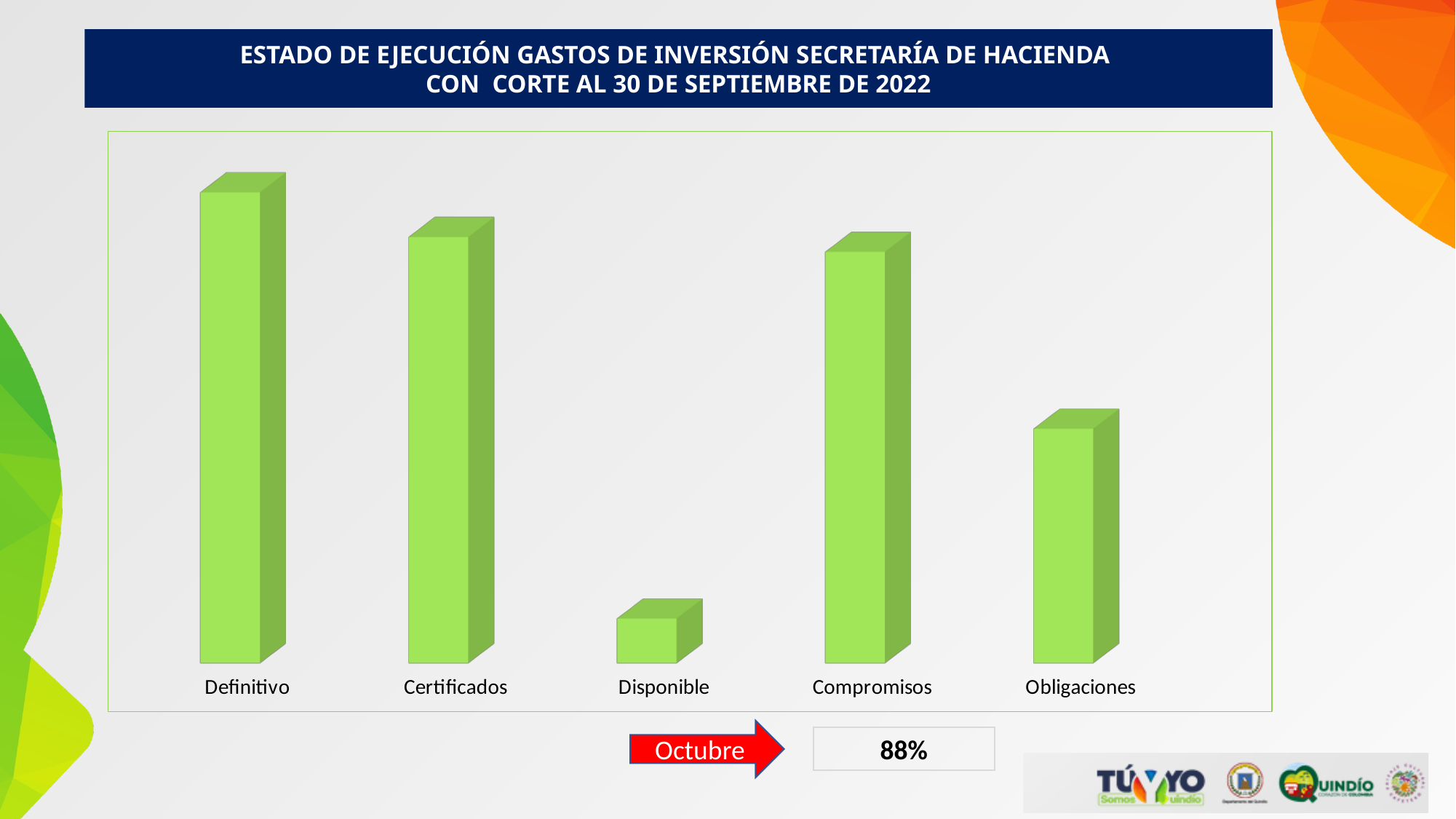
How many categories are plotted in the chart? 5 Which is larger, the bar for Disponible or the bar for Obligaciones? Obligaciones Which category has the lowest bar in the chart? Disponible What is the label of the first category on the left of the chart? Definitivo What colour are the bars in the chart? green Which is larger, the bar for Definitivo or the bar for Obligaciones? Definitivo What kind of chart is shown on the slide? bar chart Which category has the highest bar in the chart? Definitivo Which is larger, the bar for Certificados or the bar for Disponible? Certificados